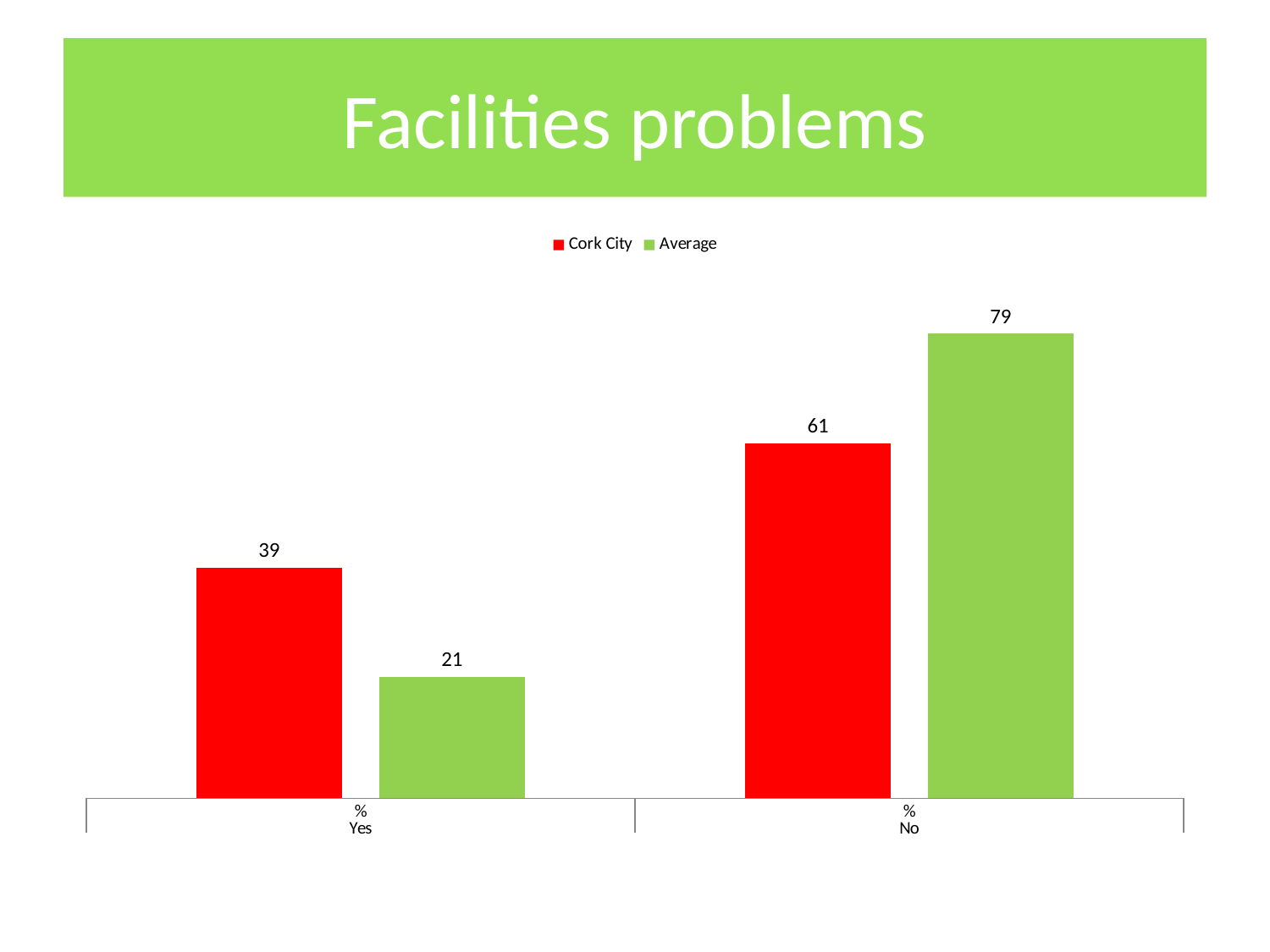
What kind of chart is shown on the slide? Bar chart What is the Cork City value for Yes? 39 What is the Average value for No? 79 For No, which series has the larger value, Cork City or Average? Average How many categories are shown on the x axis? 2 What is the difference between the Average and Cork City values for No? 18 What is the difference between the Cork City and Average values for Yes? 18 Which category has the lowest Cork City value? Yes Which category has the highest Average value? No What is the Average value for Yes? 21 How many series does the legend list? 2 What is the Cork City value for No? 61